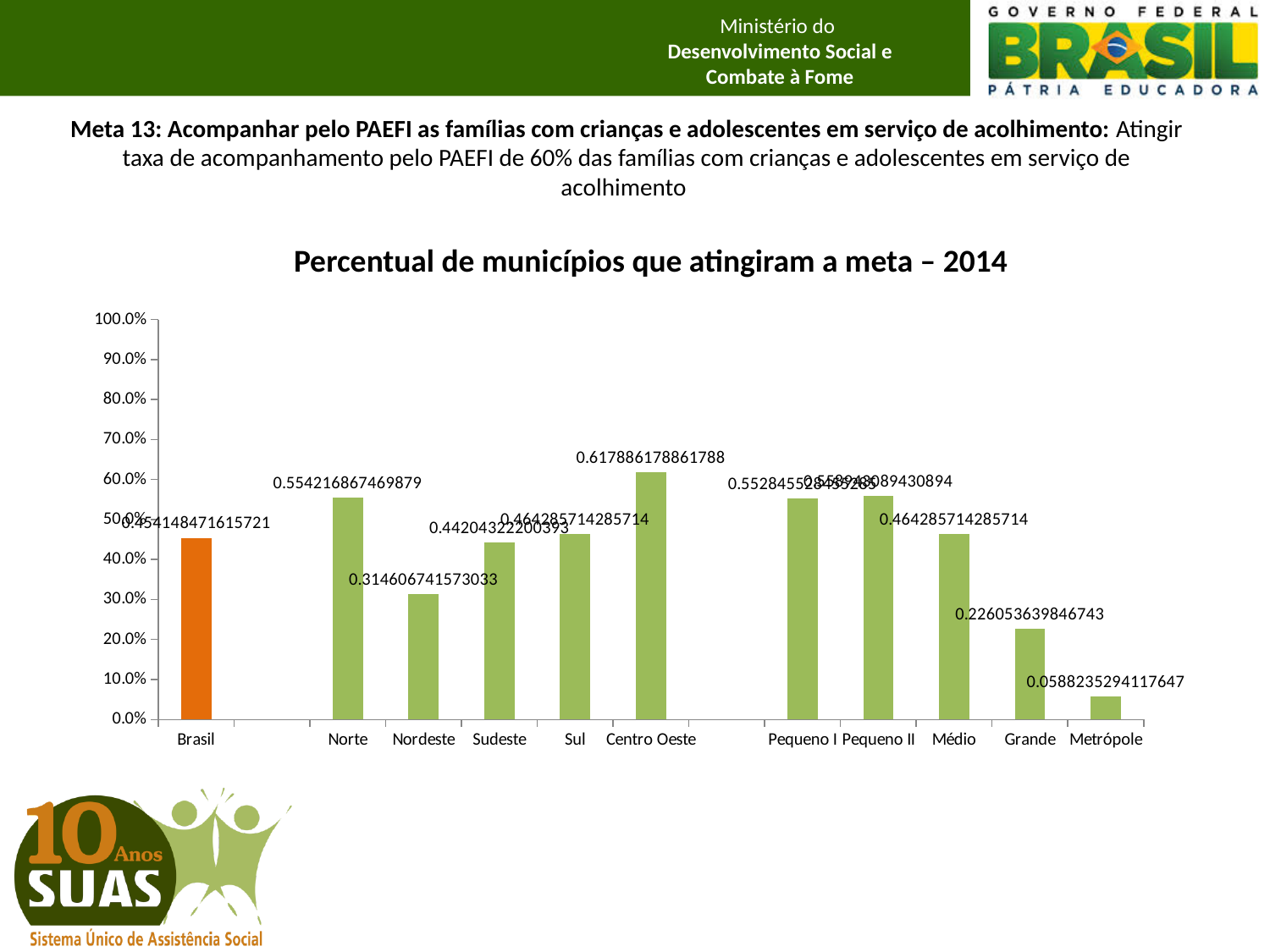
What is the value shown for Nordeste? 0.314606741573033 What is the value shown for Metrópole? 0.0588235294117647 What is the value shown for Grande? 0.226053639846743 Which category has the lowest value? Metrópole Which is larger, the value for Norte or the value for Nordeste? Norte What is the difference between the values for Centro Oeste and Nordeste? 0.303279437288755 Is the value for Brasil greater or less than 50.0%? less What is the value shown for Norte? 0.554216867469879 Which category has the highest value? Centro Oeste How many categories are shown on the x axis? 11 What is the value shown for Centro Oeste? 0.617886178861788 What type of chart is shown on the slide? bar chart